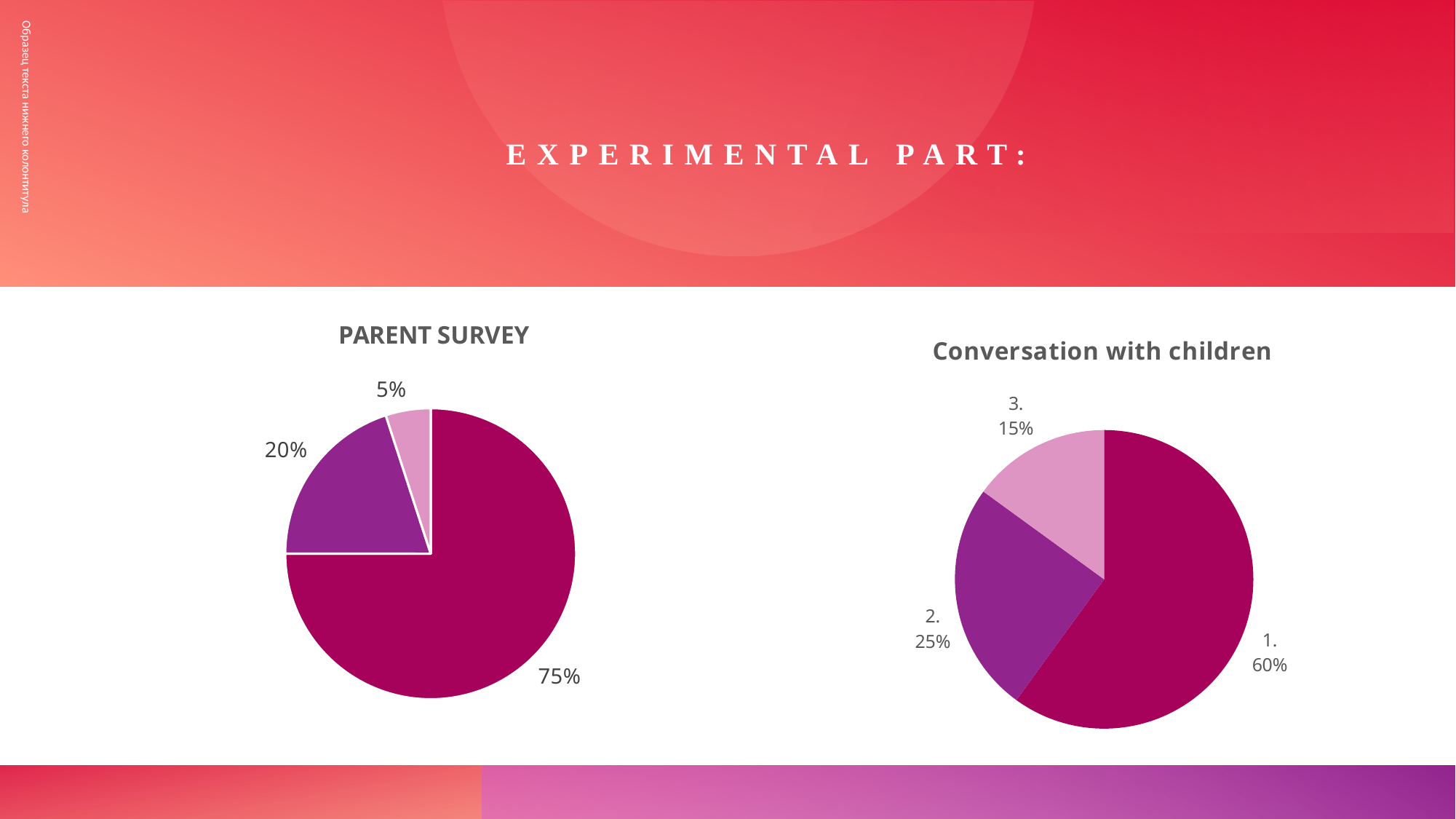
In the "PARENT SURVEY" chart, what is the difference in percentage points between the largest slice and the smallest slice? 70 In the "Conversation with children" chart, what is the share for category 2? 25% In the "Conversation with children" chart, what is the share for category 1? 60% In the "PARENT SURVEY" chart, what is the share of the largest slice? 75% What type of chart is the "Conversation with children" chart? pie chart In the "PARENT SURVEY" chart, how many slices does the pie have? 3 In the "Conversation with children" chart, which is larger, category 2 or category 3? category 2 In the "PARENT SURVEY" chart, what is the share of the smallest slice? 5% In the "Conversation with children" chart, what is the difference in percentage points between category 1 and category 2? 35 In the "Conversation with children" chart, which category has the smallest slice? 3. In the "Conversation with children" chart, what is the share for category 3? 15% What type of chart is the "PARENT SURVEY" chart? pie chart